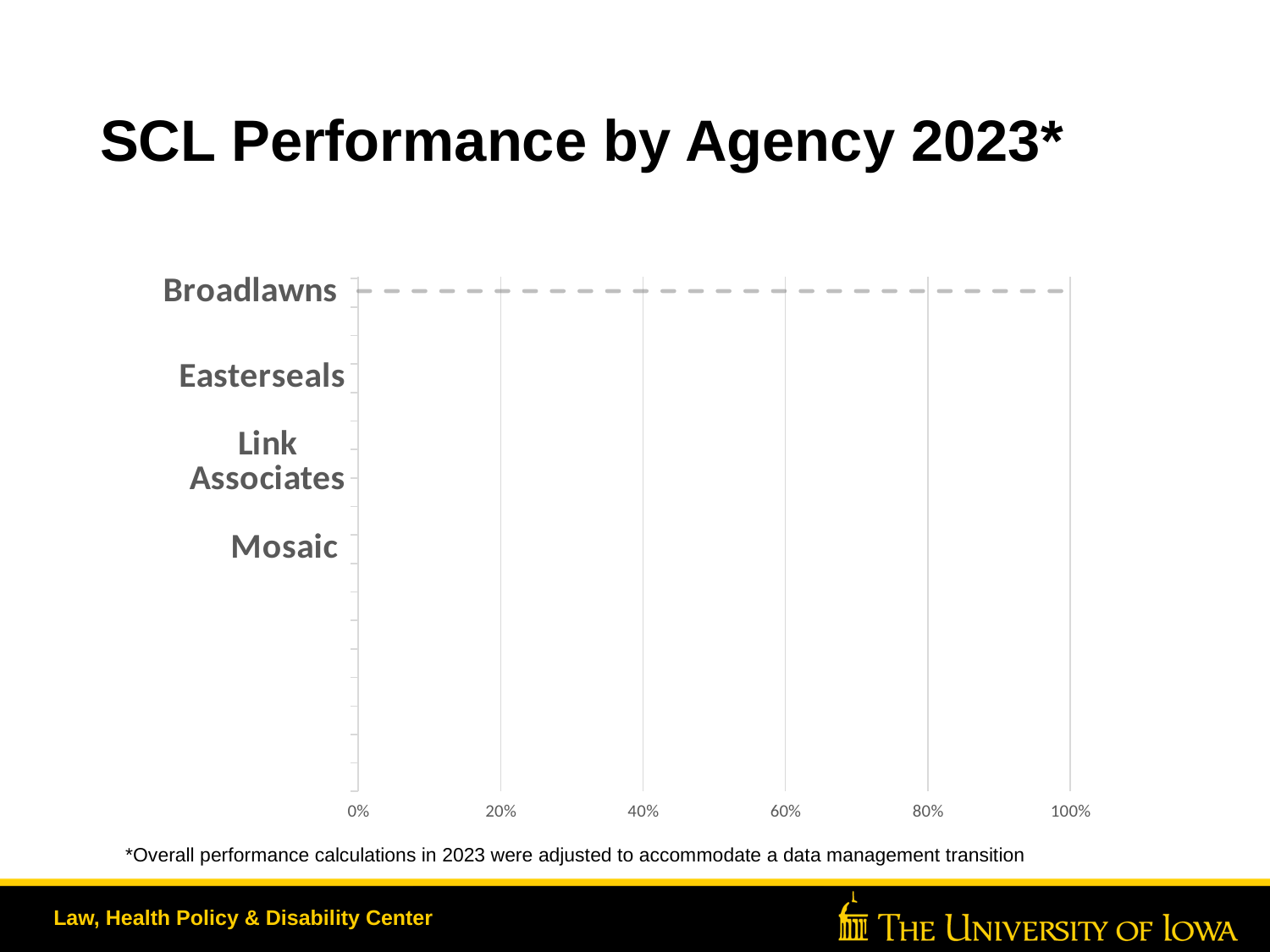
What value does the dashed line for Broadlawns reach on the horizontal axis? 100% Which agency is listed first (at the top) on the vertical axis? Broadlawns What is the title of the chart? SCL Performance by Agency 2023* How many agencies are listed on the vertical axis of the chart? 4 What kind of chart is shown on the slide? bar chart What is the highest value shown on the horizontal axis? 100% Which agency is listed last (at the bottom) on the vertical axis? Mosaic